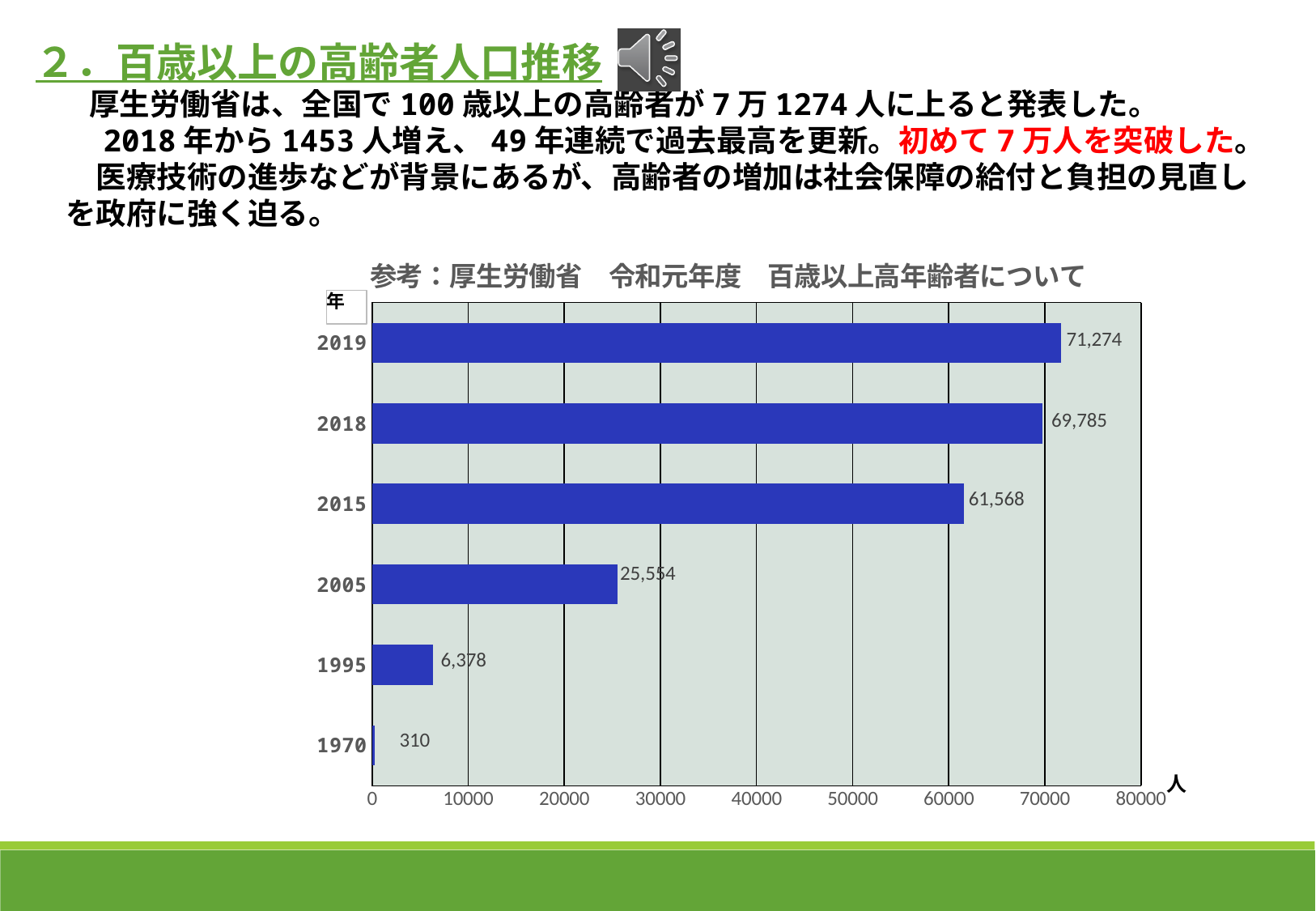
What is the difference between the values for 2015 and 2005? 36,014 What kind of chart is shown on the slide? Bar chart Do the values rise or fall from 1970 to 2019? Rise What is the value for 2005 in the chart? 25,554 How many years are shown in the chart? 6 Which year has the highest value in the chart? 2019 What is the value for 2019 in the chart? 71,274 Is the value for 2018 greater or less than 70000? less What is the difference between the values for 2019 and 2018? 1,489 What is the value for 1970 in the chart? 310 Which year has the lowest value in the chart? 1970 Which is larger, the value for 2015 or the value for 2005? 2015